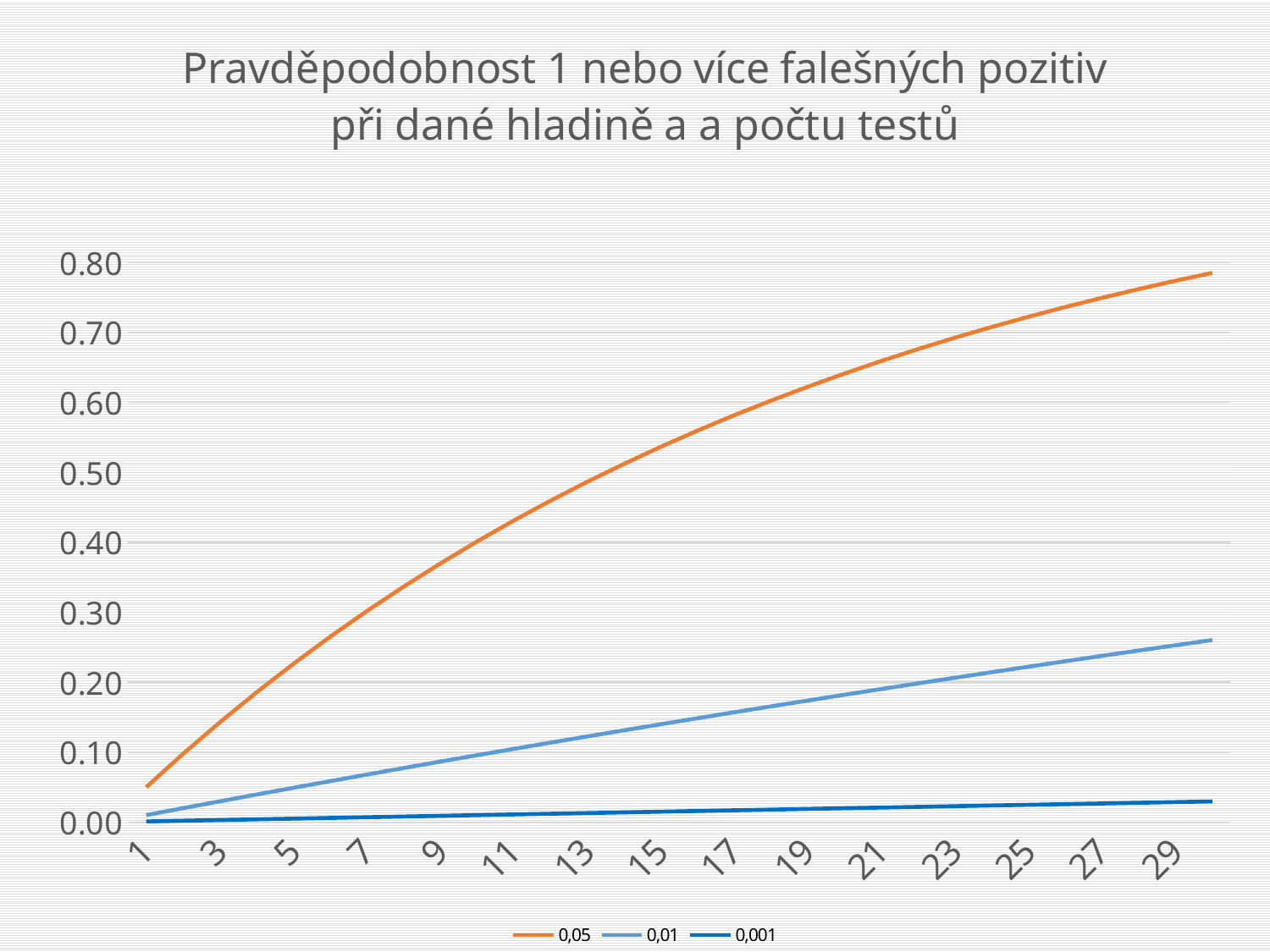
How many series does the legend list? 3 Do the values of the 0,05 series rise or fall as the number of tests increases along the x axis? rise Which series is drawn in orange? 0,05 Which series reaches the highest value at the right end of the chart? 0,05 Is the value of the 0,05 series at 1 test greater or less than 0.10? less Which series stays lowest across the whole chart? 0,001 Is the value of the 0,05 series at 29 tests greater or less than 0.70? greater Is the value of the 0,01 series at 29 tests greater or less than 0.20? greater What kind of chart is shown on the slide? line chart What is the title of the chart? Pravděpodobnost 1 nebo více falešných pozitiv při dané hladině a a počtu testů At 15 tests, which series has the larger value, 0,05 or 0,01? 0,05